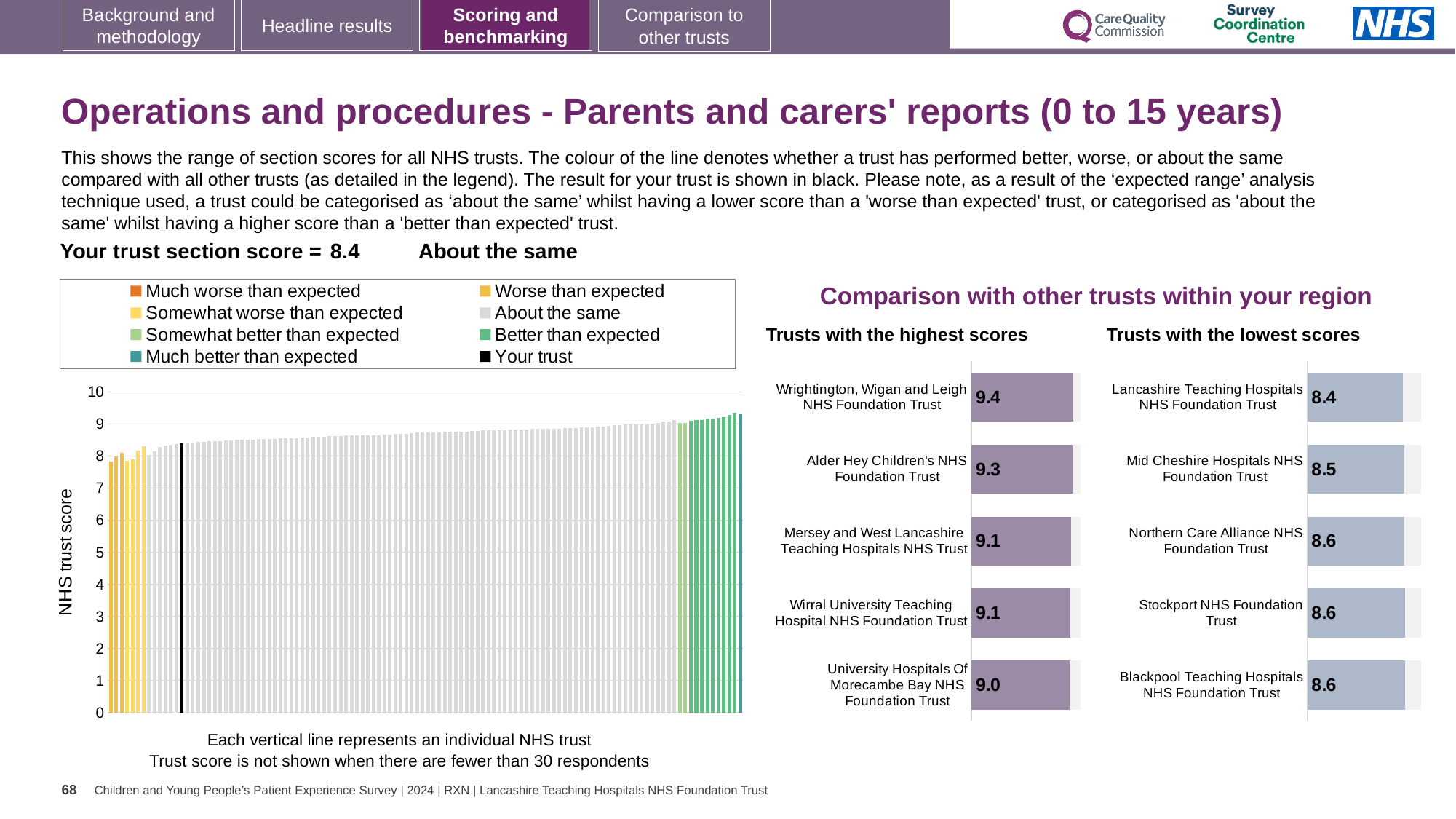
How many entries does the legend of the main NHS trust score chart list? 8 In the 'Trusts with the highest scores' chart, which has the higher score: Alder Hey Children's NHS Foundation Trust or Mersey and West Lancashire Teaching Hospitals NHS Trust? Alder Hey Children's NHS Foundation Trust In the 'Trusts with the highest scores' chart, which trust has the highest score? Wrightington, Wigan and Leigh NHS Foundation Trust What kind of chart is the main chart showing the range of section scores for all NHS trusts? bar chart In the 'Trusts with the highest scores' chart, what is the score for Wrightington, Wigan and Leigh NHS Foundation Trust? 9.4 In the 'Trusts with the lowest scores' chart, which trust has the lowest score? Lancashire Teaching Hospitals NHS Foundation Trust What is the label on the vertical axis of the main chart? NHS trust score How many trusts are shown in the 'Trusts with the highest scores' chart? 5 In the 'Trusts with the lowest scores' chart, what is the score for Mid Cheshire Hospitals NHS Foundation Trust? 8.5 In the main chart, is the value for 'Your trust' (the black bar) greater or less than 8? greater In the 'Trusts with the highest scores' chart, what is the difference between the scores of Wrightington, Wigan and Leigh NHS Foundation Trust and University Hospitals Of Morecambe Bay NHS Foundation Trust? 0.4 In the 'Trusts with the lowest scores' chart, what is the difference between the scores of Blackpool Teaching Hospitals NHS Foundation Trust and Lancashire Teaching Hospitals NHS Foundation Trust? 0.2